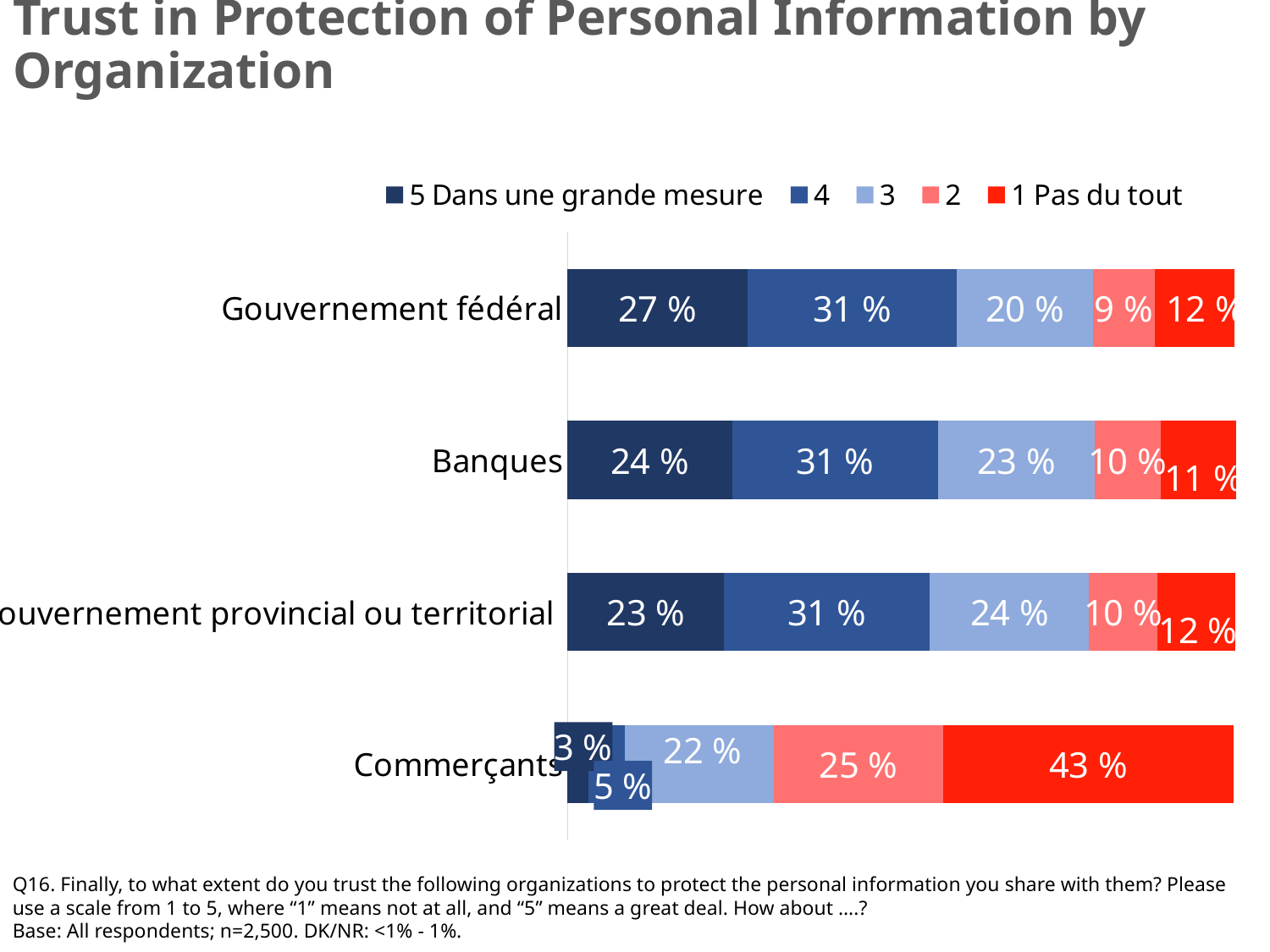
What is the value of the '3' segment for Banques? 23 % What percentage of respondents gave Gouvernement fédéral a rating of 5 (Dans une grande mesure)? 27 % Which is larger: the '2' segment for Commerçants or the '2' segment for Gouvernement fédéral? Commerçants What is the total of all segments in the Commerçants bar? 98 % How many organizations (categories) are plotted in the chart? 4 What kind of chart is shown on the slide? Stacked bar chart What is the value of the '1 Pas du tout' segment for Commerçants? 43 % Which legend entry is shown in bright red? 1 Pas du tout How many series does the legend list? 5 What is the difference between the '5 Dans une grande mesure' values for Gouvernement fédéral and Banques? 3 % Which organization has the highest '1 Pas du tout' value? Commerçants Which organization has the lowest '5 Dans une grande mesure' value? Commerçants